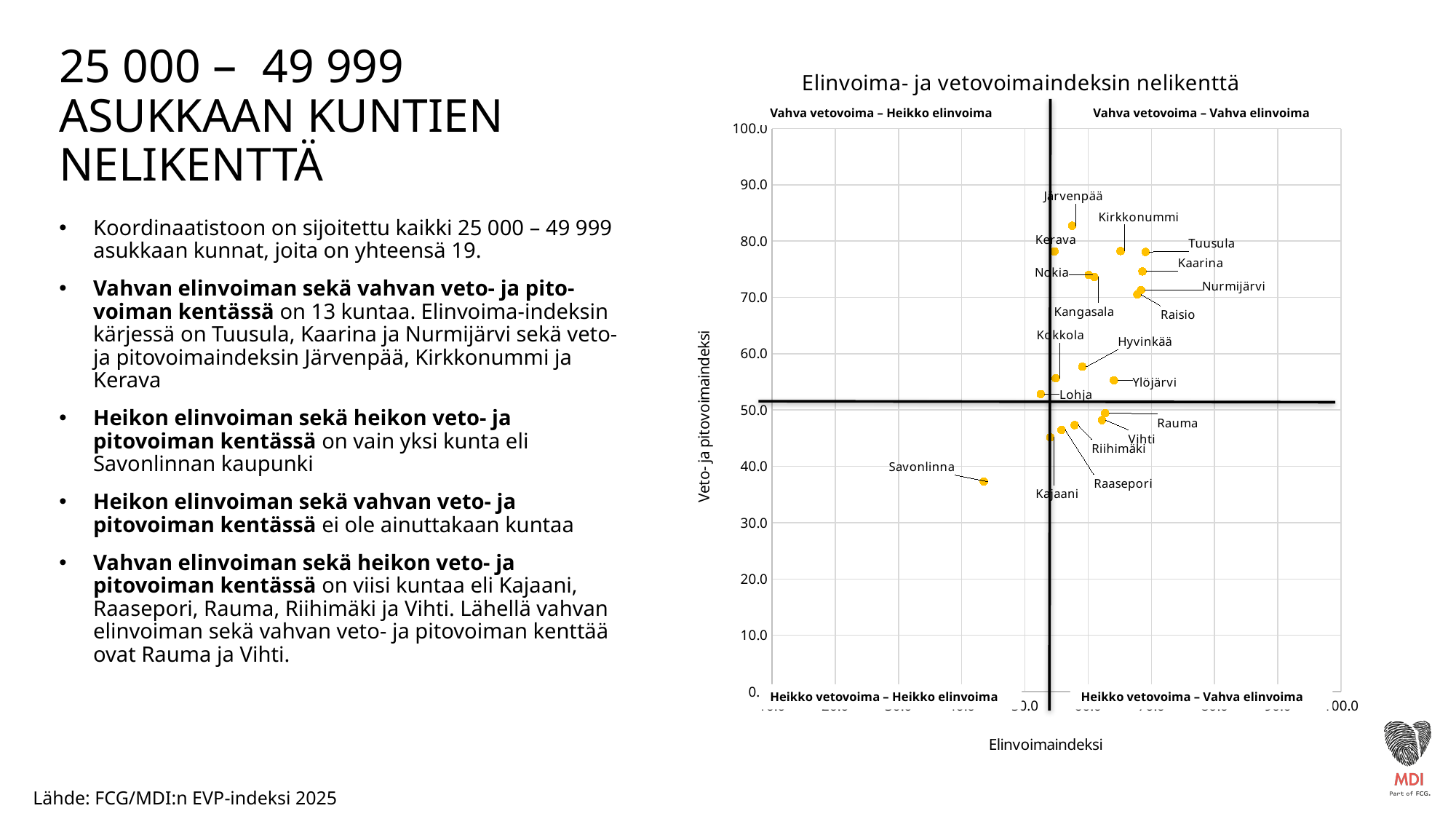
Is the Veto- ja pitovoimaindeksi value for Savonlinna greater or less than 40? less What kind of chart is shown on the slide? scatter chart Which municipality has the lowest Veto- ja pitovoimaindeksi value in the chart? Savonlinna In which quadrant of the chart is Savonlinna located? Heikko vetovoima – Heikko elinvoima Is the Veto- ja pitovoimaindeksi value for Kokkola greater or less than 50? greater Is the Veto- ja pitovoimaindeksi value for Järvenpää greater or less than 80? greater Which has the higher Veto- ja pitovoimaindeksi value, Järvenpää or Savonlinna? Järvenpää Which municipality has the highest Veto- ja pitovoimaindeksi value in the chart? Järvenpää What is the title of the chart? Elinvoima- ja vetovoimaindeksin nelikenttä How many municipalities are plotted as points in the chart? 19